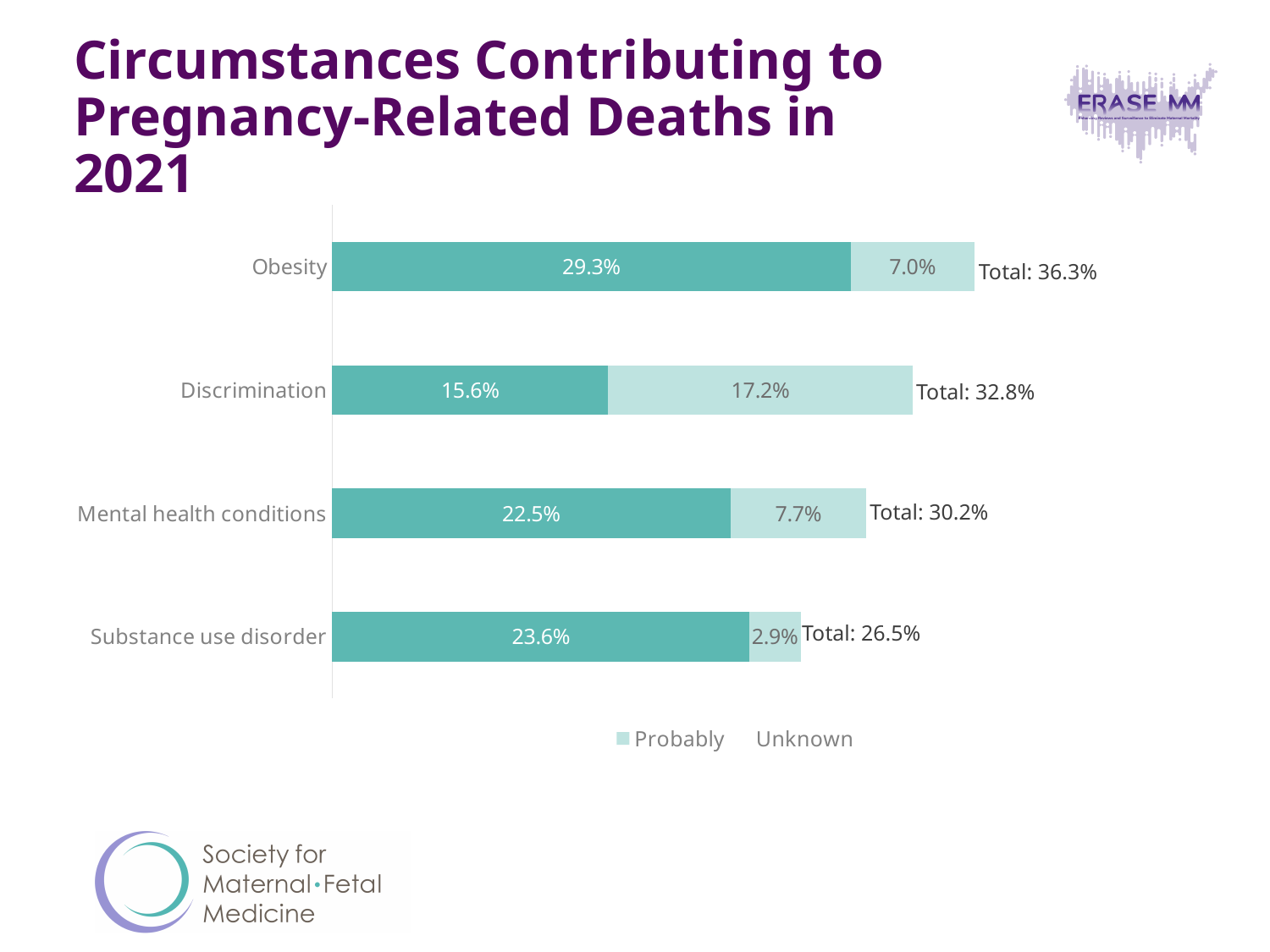
Which category has the highest total? Obesity What is the total for Discrimination? 32.8% What is the 'Probably' value for Obesity? 7.0% How many series does the legend list? 2 What is the 'Probably' value for Mental health conditions? 7.7% How many categories are shown in the chart? 4 What kind of chart is shown on the slide? Stacked bar chart What is the difference between the 'Probably' values for Obesity and Substance use disorder? 4.1% Which category has the lowest 'Probably' value? Substance use disorder